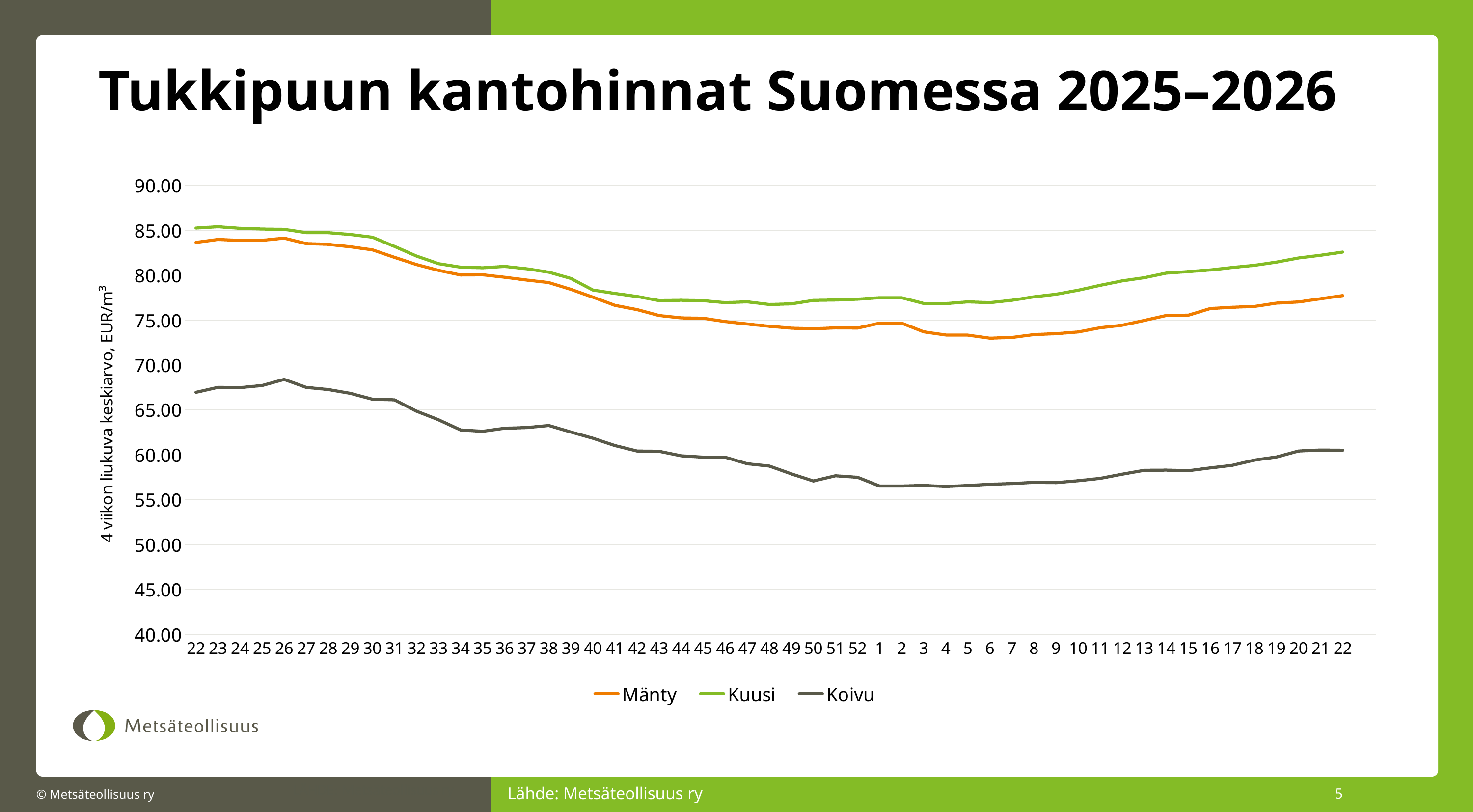
At week 40, which is larger, the value for Kuusi or the value for Mänty? Kuusi Is the value for Mänty at week 6 greater or less than 75.00? less Does the Koivu line rise or fall from week 26 to week 1? fall Which series has the lowest values across the whole chart? Koivu Is the value for Koivu at week 26 greater or less than 65.00? greater What kind of chart is shown on the slide? line chart Is the value for Kuusi at the first week 22 greater or less than 80.00? greater Which series has the highest values across the whole chart? Kuusi How many series does the legend list? 3 What is the title of the chart on the slide? Tukkipuun kantohinnat Suomessa 2025–2026 Which series are listed in the legend? Mänty, Kuusi, Koivu